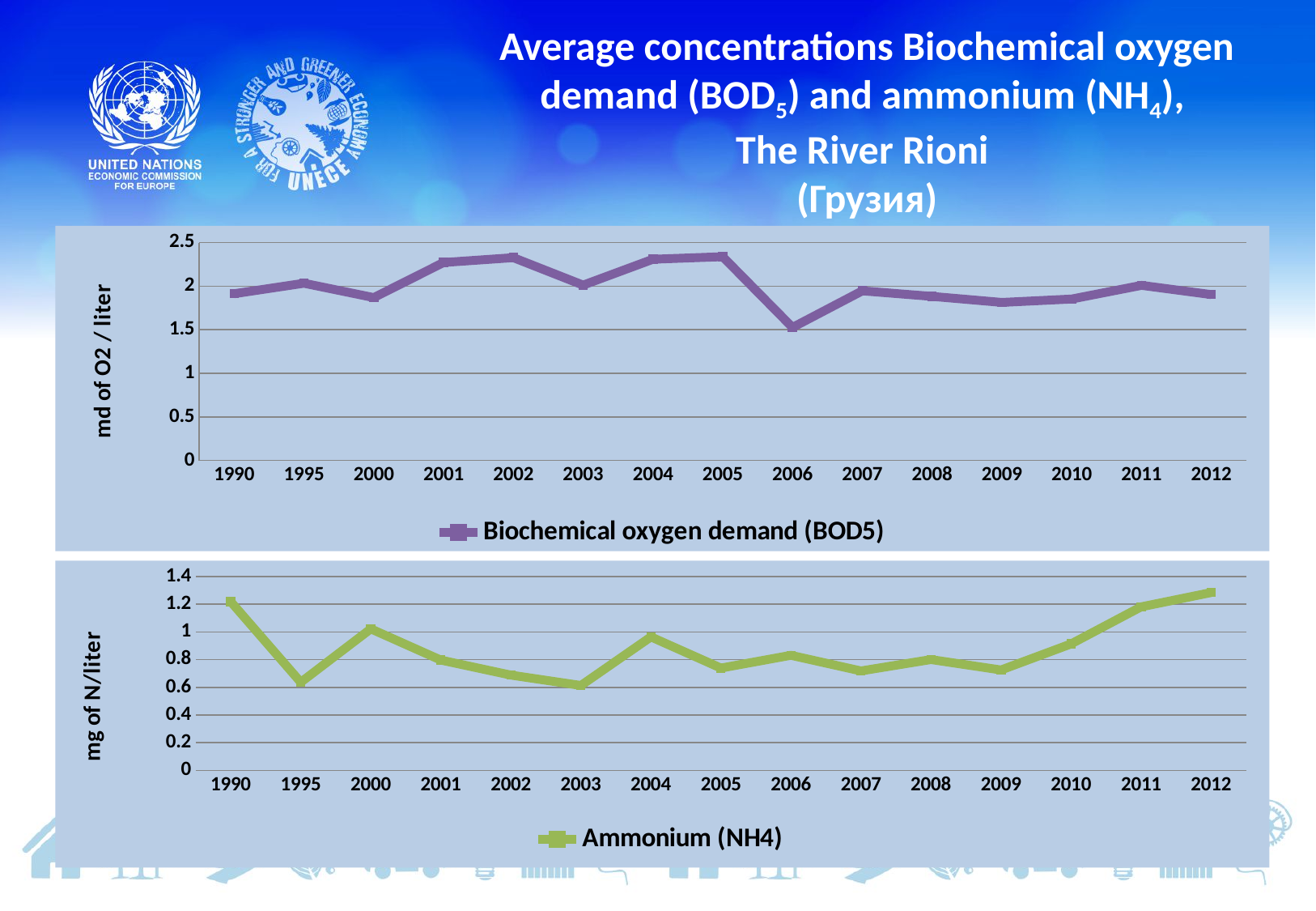
In the bottom chart (Ammonium), how many series does the legend list? 1 In the bottom chart (Ammonium), which is larger, the value for 1995 or the value for 2000? 2000 In the top chart (Biochemical oxygen demand), how many years are plotted along the x axis? 15 In the bottom chart (Ammonium), do the values rise or fall from 2009 to 2012? rise In the bottom chart (Ammonium), is the value for 2003 greater or less than 0.8? less In the bottom chart (Ammonium), is the value for 1990 greater or less than 1? greater In the top chart (Biochemical oxygen demand), is the value for 2002 greater or less than 2? greater What kind of chart is the bottom chart (Ammonium)? line chart What kind of chart is the top chart (Biochemical oxygen demand)? line chart In the top chart (Biochemical oxygen demand), which year has the lowest value? 2006 In the top chart (Biochemical oxygen demand), which is larger, the value for 2005 or the value for 2006? 2005